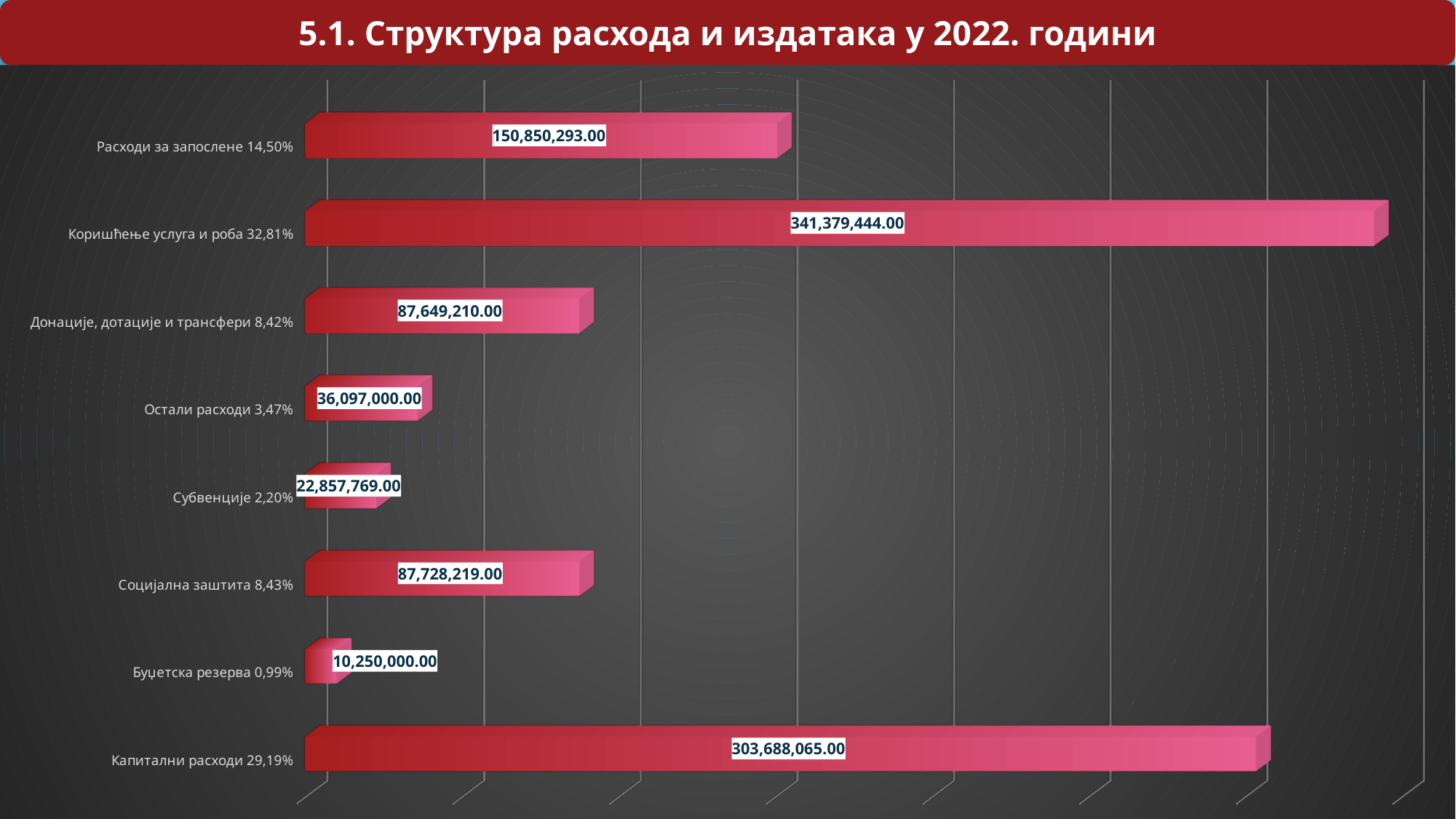
Which category has the highest value? Коришћење услуга и роба How many categories are shown in the chart? 8 What is the value for Субвенције? 22,857,769.00 What is the value for Коришћење услуга и роба? 341,379,444.00 What is the value for Капитални расходи? 303,688,065.00 What percentage share is shown in the label for Капитални расходи? 29,19% Which is larger, the value for Остали расходи or the value for Субвенције? Остали расходи What is the difference between the values for Расходи за запослене and Донације, дотације и трансфери? 63,201,083.00 What is the difference between the values for Коришћење услуга и роба and Капитални расходи? 37,691,379.00 Which category has the lowest value? Буџетска резерва What kind of chart is shown on the slide? Bar chart What is the value for Буџетска резерва? 10,250,000.00